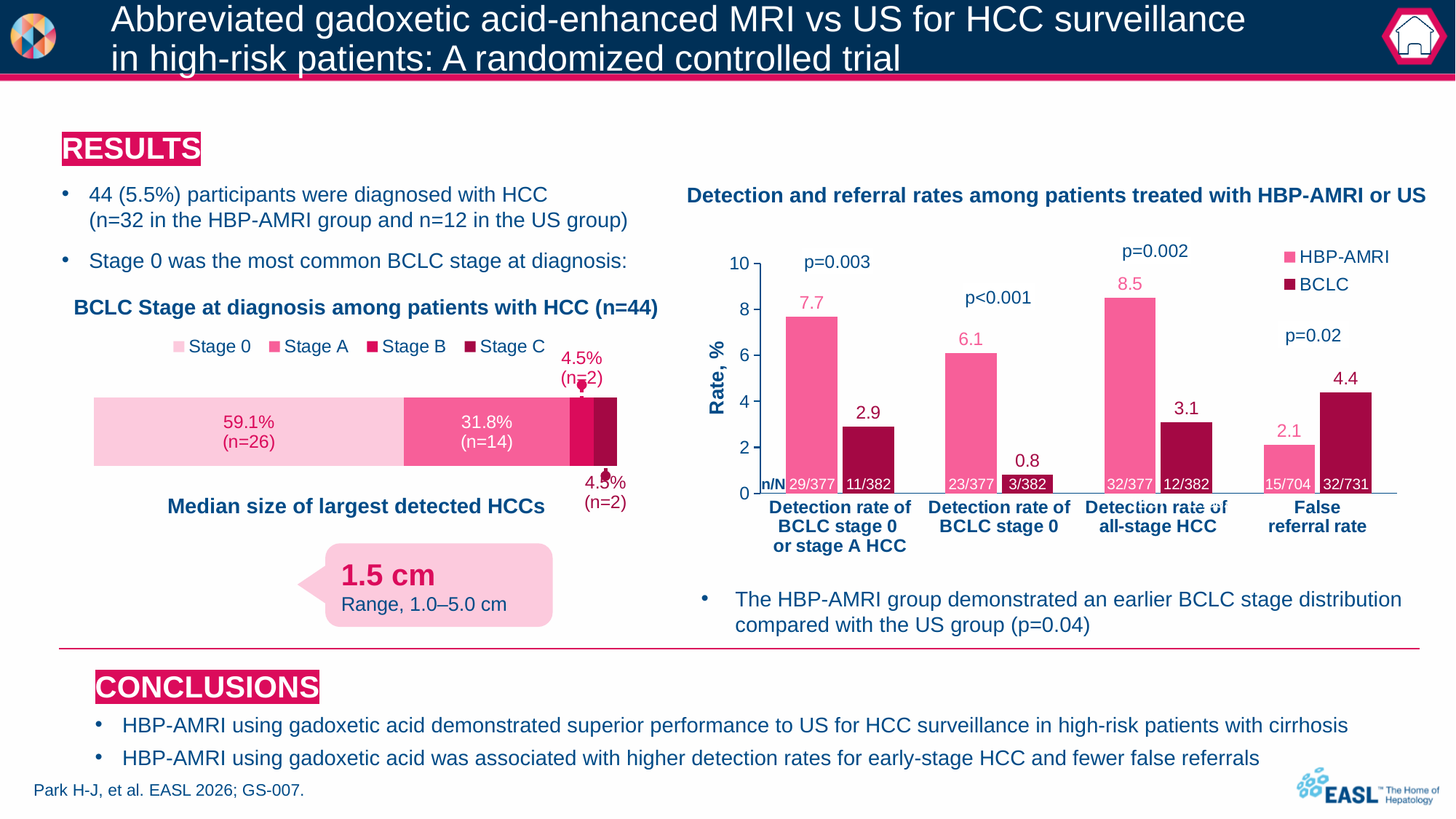
What type of chart is the 'Detection and referral rates among patients treated with HBP-AMRI or US' chart? Bar chart In the 'Detection and referral rates' chart, what is the HBP-AMRI false referral rate? 2.1 In the 'Detection and referral rates' chart, what is the difference between the HBP-AMRI and dark red bar values for detection rate of all-stage HCC? 5.4 In the 'Detection and referral rates' chart, what p-value is shown above the false referral rate bars? p=0.02 In the 'BCLC Stage at diagnosis' chart, how many stages does the legend list? 4 In the 'Detection and referral rates' chart, which is larger for the false referral rate: the HBP-AMRI bar or the dark red bar? The dark red bar (4.4) In the 'Detection and referral rates' chart, which category has the highest HBP-AMRI value? Detection rate of all-stage HCC In the 'Detection and referral rates' chart, what is the value of the dark red bar for detection rate of BCLC stage 0? 0.8 In the 'Detection and referral rates' chart, how many categories are shown on the x axis? 4 In the 'Detection and referral rates' chart, what is the HBP-AMRI value for detection rate of BCLC stage 0 or stage A HCC? 7.7 In the 'BCLC Stage at diagnosis' chart, how many patients were Stage A? 14 In the 'BCLC Stage at diagnosis' chart, what percentage of patients were Stage 0? 59.1%